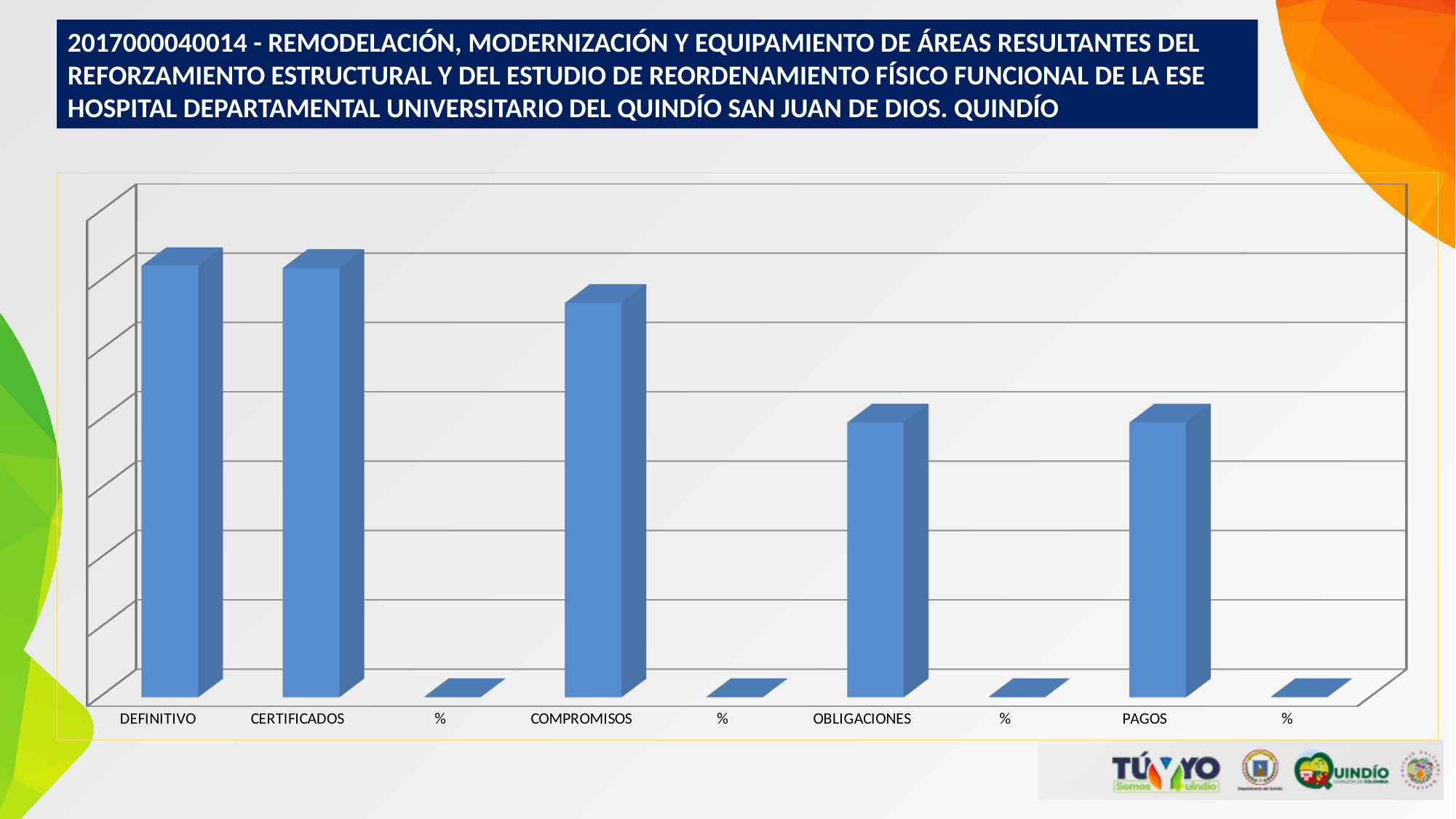
Which is larger, the bar for COMPROMISOS or the bar for OBLIGACIONES? COMPROMISOS Which is larger, the bar for COMPROMISOS or the bar for PAGOS? COMPROMISOS Which is larger, the bar for CERTIFICADOS or the bar for COMPROMISOS? CERTIFICADOS How many categories are shown along the x axis of the chart? 9 What is the label of the first category on the x axis? DEFINITIVO What kind of chart is shown on the slide? Bar chart What colour are the bars in the chart? Blue